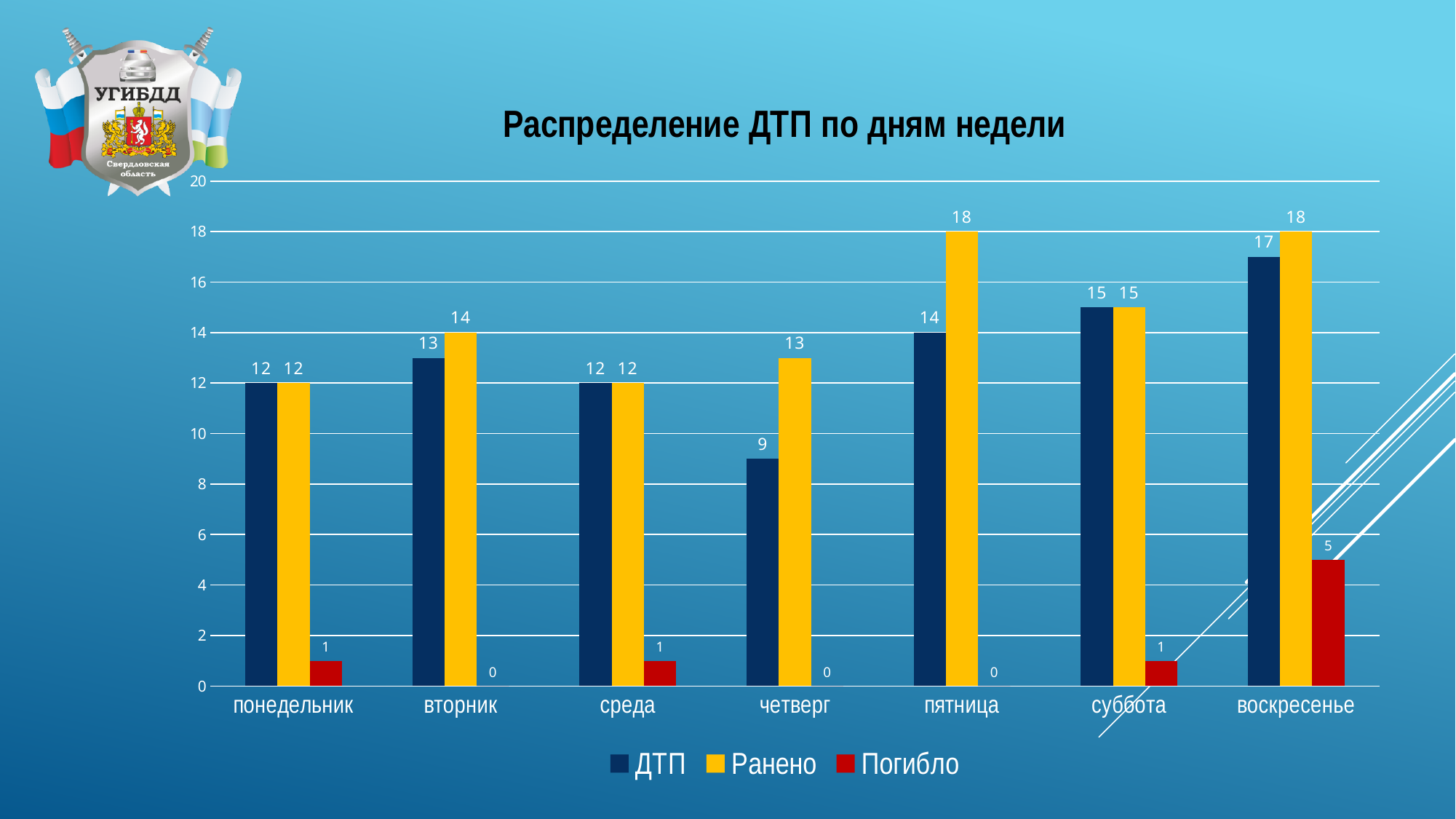
What colour are the Погибло bars? red What is the value of Ранено for пятница? 18 What kind of chart is shown on the slide? bar chart What is the value of Погибло for воскресенье? 5 How many days of the week are shown on the x axis? 7 How many series does the legend list? 3 What is the title of the chart? Распределение ДТП по дням недели Which day has the highest ДТП value? воскресенье Which day has the lowest ДТП value? четверг What is the value of ДТП for четверг? 9 What is the difference between the Ранено value for пятница and the Ранено value for четверг? 5 Which is larger: the ДТП value for вторник or the ДТП value for среда? вторник